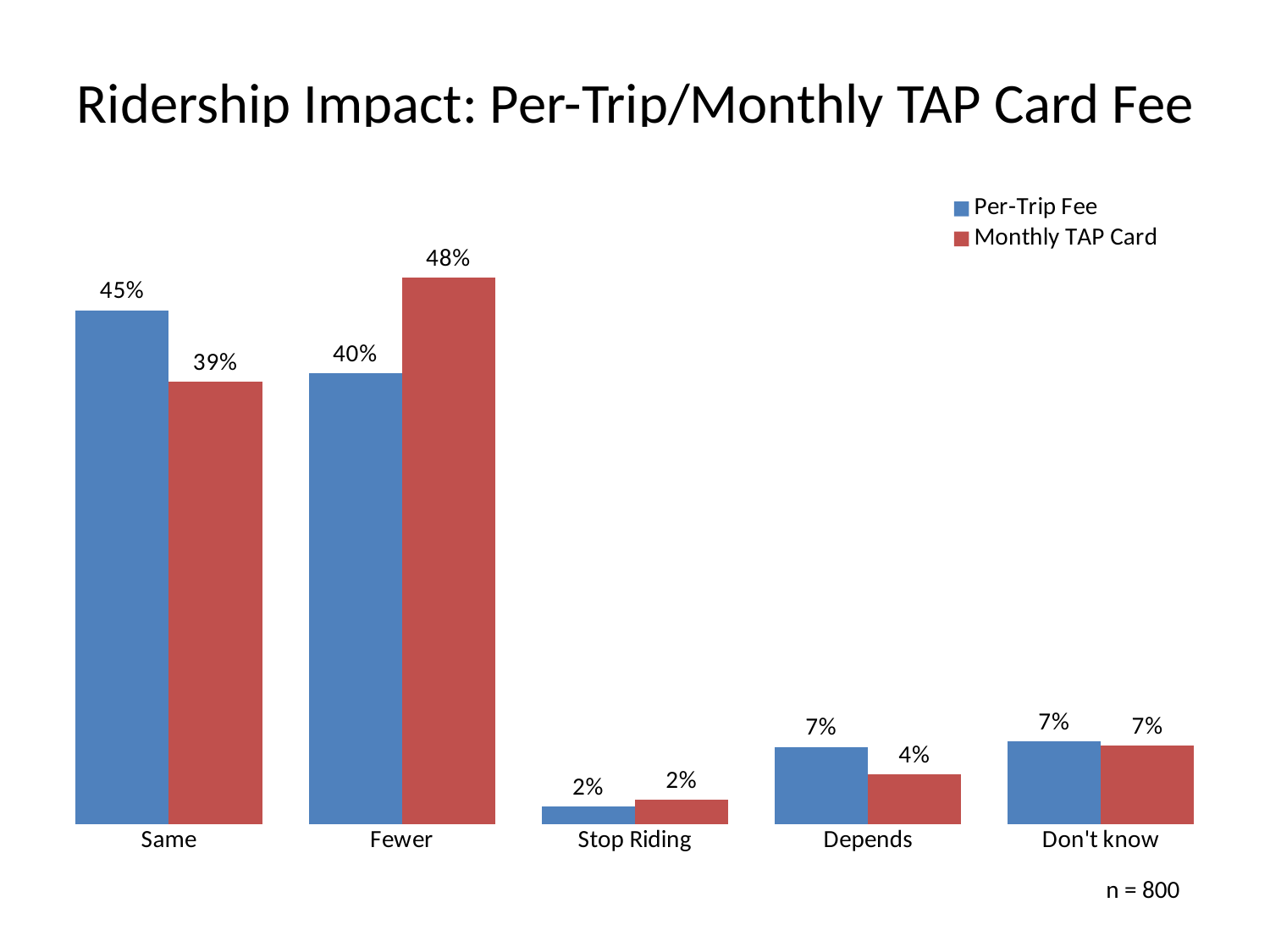
Which category has the lowest Per-Trip Fee value? Stop Riding Which is larger for the Same category, the Per-Trip Fee value or the Monthly TAP Card value? Per-Trip Fee What is the title of the chart? Ridership Impact: Per-Trip/Monthly TAP Card Fee How many categories are shown on the x axis? 5 What is the Monthly TAP Card value for the Depends category? 4% What is the Monthly TAP Card value for the Fewer category? 48% Which category has the highest Monthly TAP Card value? Fewer What kind of chart is shown on the slide? Bar chart What is the Per-Trip Fee value for the Same category? 45% What is the difference between the Monthly TAP Card and Per-Trip Fee values for the Fewer category? 8% What sample size is noted on the slide? n = 800 How many series does the legend list? 2